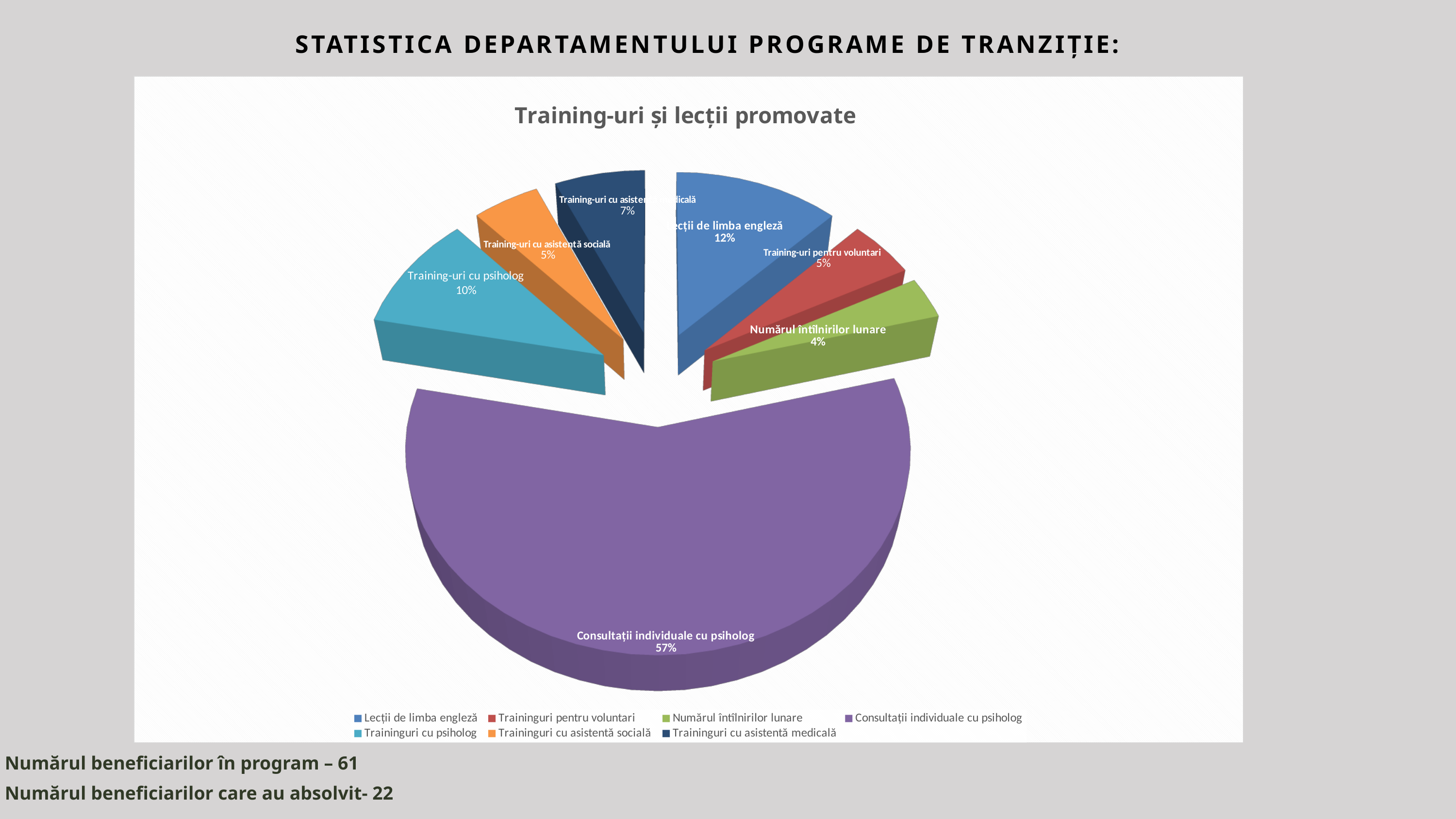
What is the difference in percentage points between "Consultații individuale cu psiholog" and "Lecții de limba engleză"? 45 Which category has the largest slice of the pie? Consultații individuale cu psiholog How many categories (slices) does the pie chart have? 7 Which is larger, the share for "Training-uri cu psiholog" or the share for "Training-uri cu asistentă medicală"? Training-uri cu psiholog What is the title of the chart? Training-uri și lecții promovate What kind of chart is shown on the slide? Pie chart What share of the pie does "Training-uri cu psiholog" represent? 10% What share of the pie does "Lecții de limba engleză" represent? 12% What share of the pie does "Consultații individuale cu psiholog" represent? 57% Which category has the smallest slice of the pie? Numărul întîlnirilor lunare